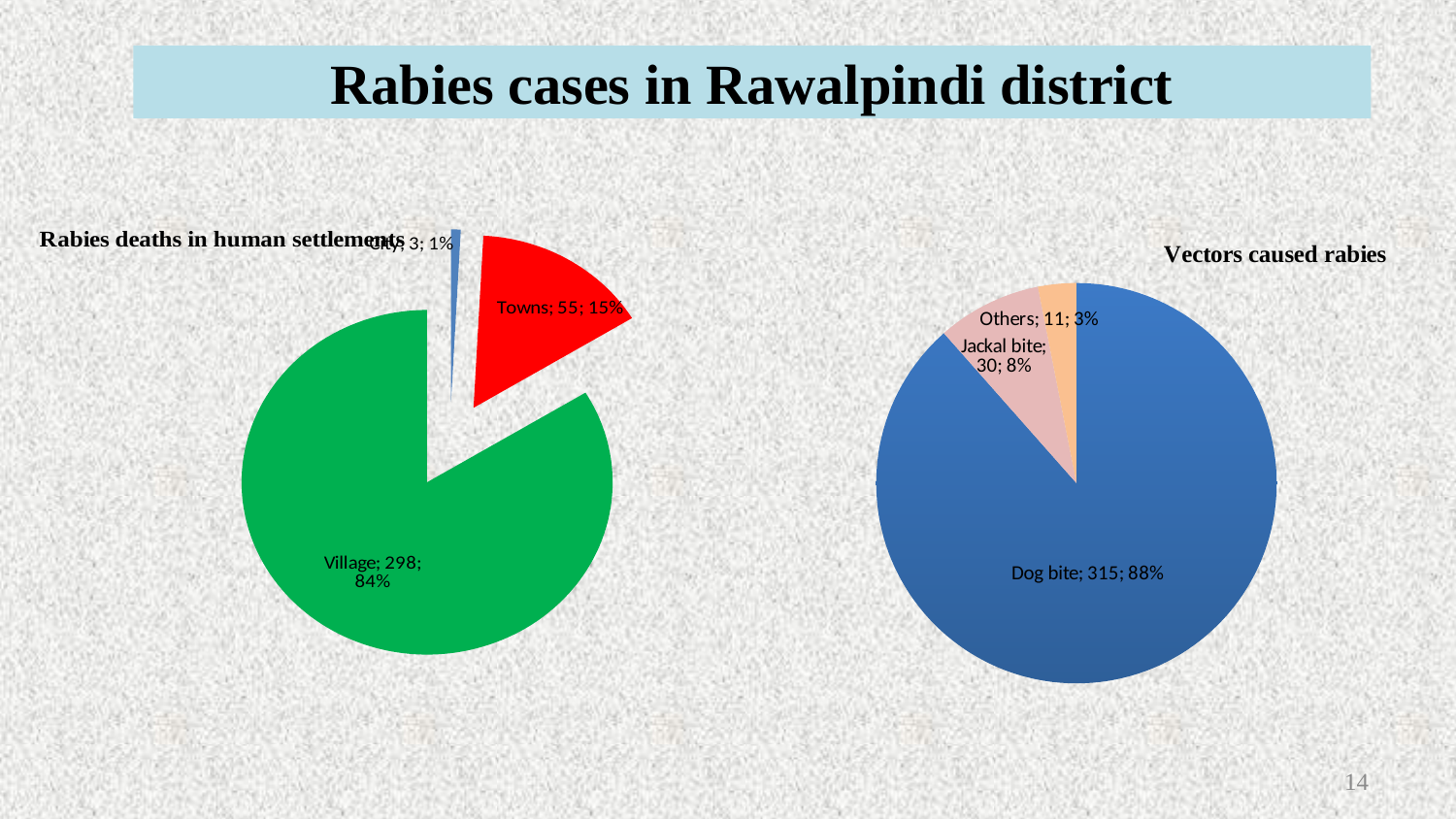
In the 'Vectors caused rabies' chart, what percentage share does Jackal bite have? 8% In the 'Vectors caused rabies' chart, which is larger, Jackal bite or Others? Jackal bite In the 'Rabies deaths in human settlements' chart, how many categories are shown? 3 In the 'Rabies deaths in human settlements' chart, what colour is the Towns slice? Red In the 'Rabies deaths in human settlements' chart, which category has the smallest slice? City What type of chart is the 'Vectors caused rabies' chart? Pie chart In the 'Vectors caused rabies' chart, how many cases are attributed to Dog bite? 315 In the 'Vectors caused rabies' chart, what is the difference between the Jackal bite and Others values? 19 In the 'Vectors caused rabies' chart, which category has the largest slice? Dog bite In the 'Rabies deaths in human settlements' chart, what is the difference between the Village and Towns values? 243 In the 'Rabies deaths in human settlements' chart, how many deaths are attributed to Village? 298 In the 'Rabies deaths in human settlements' chart, what percentage share does Towns have? 15%